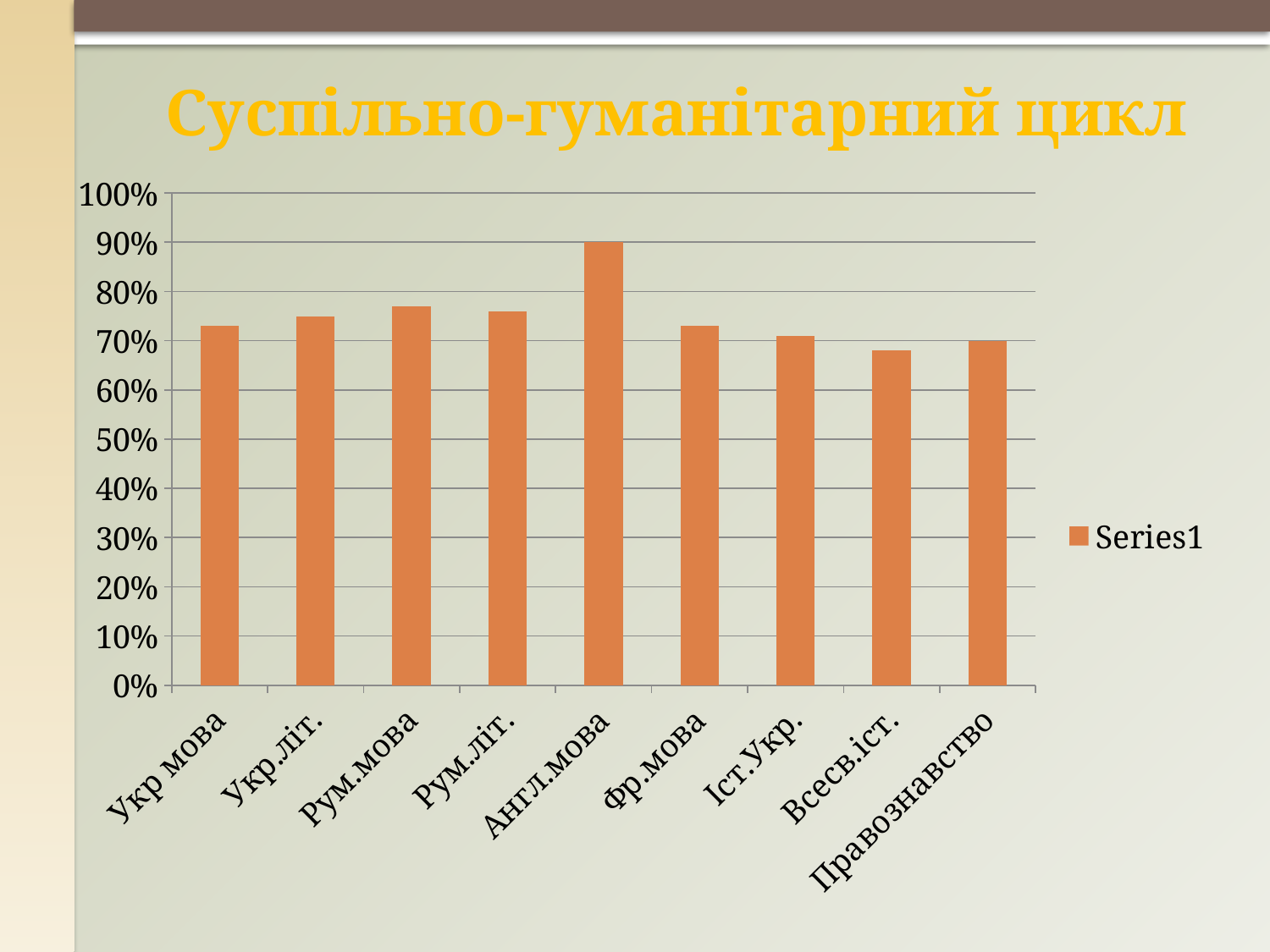
How many series does the legend list? 1 Is the value for Укр мова greater or less than 70%? greater Which is larger, the value for Англ.мова or the value for Укр мова? Англ.мова Is the value for Всесв.іст. greater or less than 70%? less Which is larger, the value for Рум.мова or the value for Всесв.іст.? Рум.мова How many categories are shown on the x axis of the chart? 9 Which category has the lowest value in the chart? Всесв.іст. Which category has the highest value in the chart? Англ.мова What is the title of the slide? Суспільно-гуманітарний цикл What kind of chart is shown on the slide? bar chart Is the value for Рум.мова greater or less than 80%? less What is the value for Англ.мова? 90%